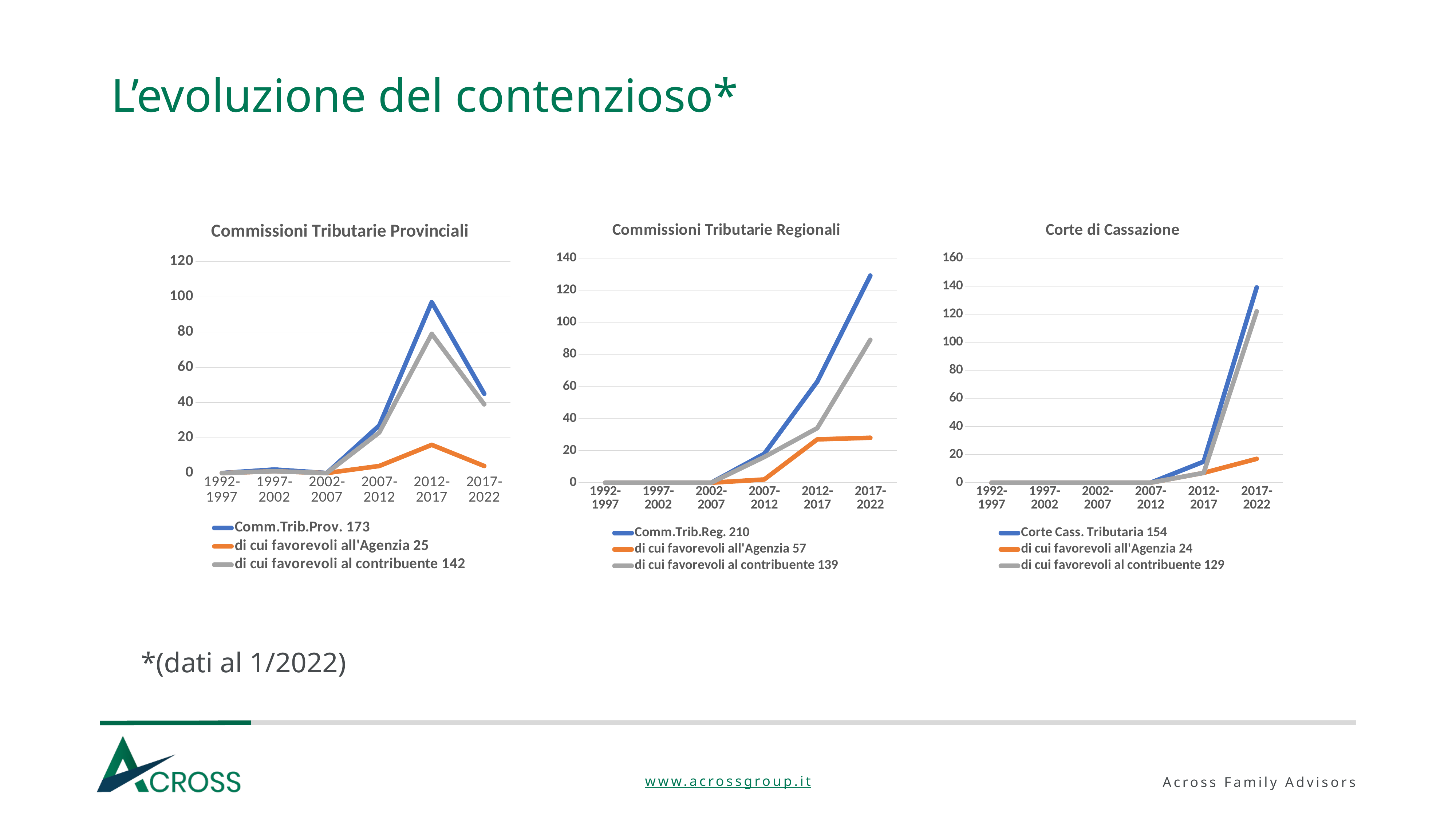
In the 'Commissioni Tributarie Provinciali' chart, in which period does the 'Comm.Trib.Prov.' series reach its highest value? 2012-2017 In the 'Corte di Cassazione' chart, is the value of the 'di cui favorevoli all'Agenzia' series for 2017-2022 greater or less than 20? less In the 'Commissioni Tributarie Provinciali' chart, which series is higher in 2012-2017: 'di cui favorevoli all'Agenzia' or 'di cui favorevoli al contribuente'? di cui favorevoli al contribuente In the 'Commissioni Tributarie Regionali' chart, does the 'Comm.Trib.Reg.' series rise or fall from 2007-2012 to 2017-2022? rise In the 'Commissioni Tributarie Regionali' chart, how many periods are shown on the x axis? 6 In the 'Corte di Cassazione' chart, in which period does the 'Corte Cass. Tributaria' series reach its highest value? 2017-2022 In the 'Corte di Cassazione' chart, what total is shown in the legend next to 'di cui favorevoli al contribuente'? 129 In the 'Corte di Cassazione' chart, how many series does the legend list? 3 In the 'Commissioni Tributarie Provinciali' chart, is the value of the 'Comm.Trib.Prov.' series for 2012-2017 greater or less than 80? greater In the 'Commissioni Tributarie Regionali' chart, is the value of the 'Comm.Trib.Reg.' series for 2017-2022 greater or less than 120? greater What kind of chart is the 'Commissioni Tributarie Provinciali' chart? line chart In the 'Commissioni Tributarie Regionali' chart, what total is shown in the legend next to 'Comm.Trib.Reg.'? 210